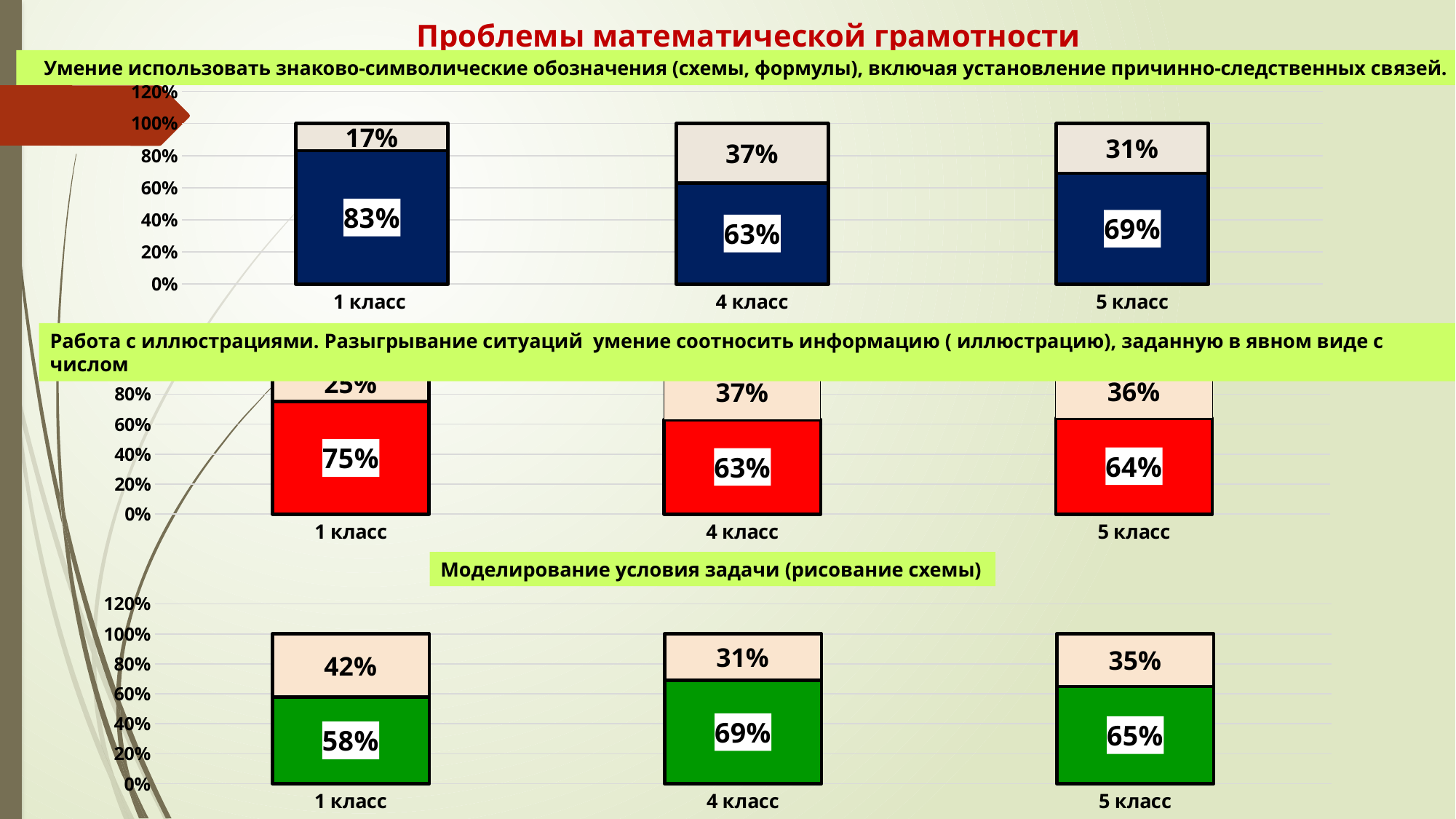
In the bottom chart (Моделирование условия задачи), is the green value for 5 класс or for 4 класс larger? 4 класс In the top chart (Умение использовать знаково-символические обозначения), what is the value of the dark blue segment for 1 класс? 83% In the middle chart (Работа с иллюстрациями), what is the total of the stacked bar for 1 класс? 100% In the bottom chart (Моделирование условия задачи), what is the value of the green segment for 4 класс? 69% In the middle chart (Работа с иллюстрациями), what is the value of the red segment for 5 класс? 64% In the top chart (Умение использовать знаково-символические обозначения), what is the value of the light beige segment for 4 класс? 37% In the bottom chart (Моделирование условия задачи), which class has the lowest green value? 1 класс In the middle chart (Работа с иллюстрациями), which class has the lowest red value? 4 класс In the top chart (Умение использовать знаково-символические обозначения), what is the difference between the dark blue values for 1 класс and 4 класс? 20% What type of chart is the top chart (Умение использовать знаково-символические обозначения)? Stacked bar chart In the top chart (Умение использовать знаково-символические обозначения), which class has the highest dark blue value? 1 класс How many categories (classes) are shown on the x axis of the bottom chart (Моделирование условия задачи)? 3